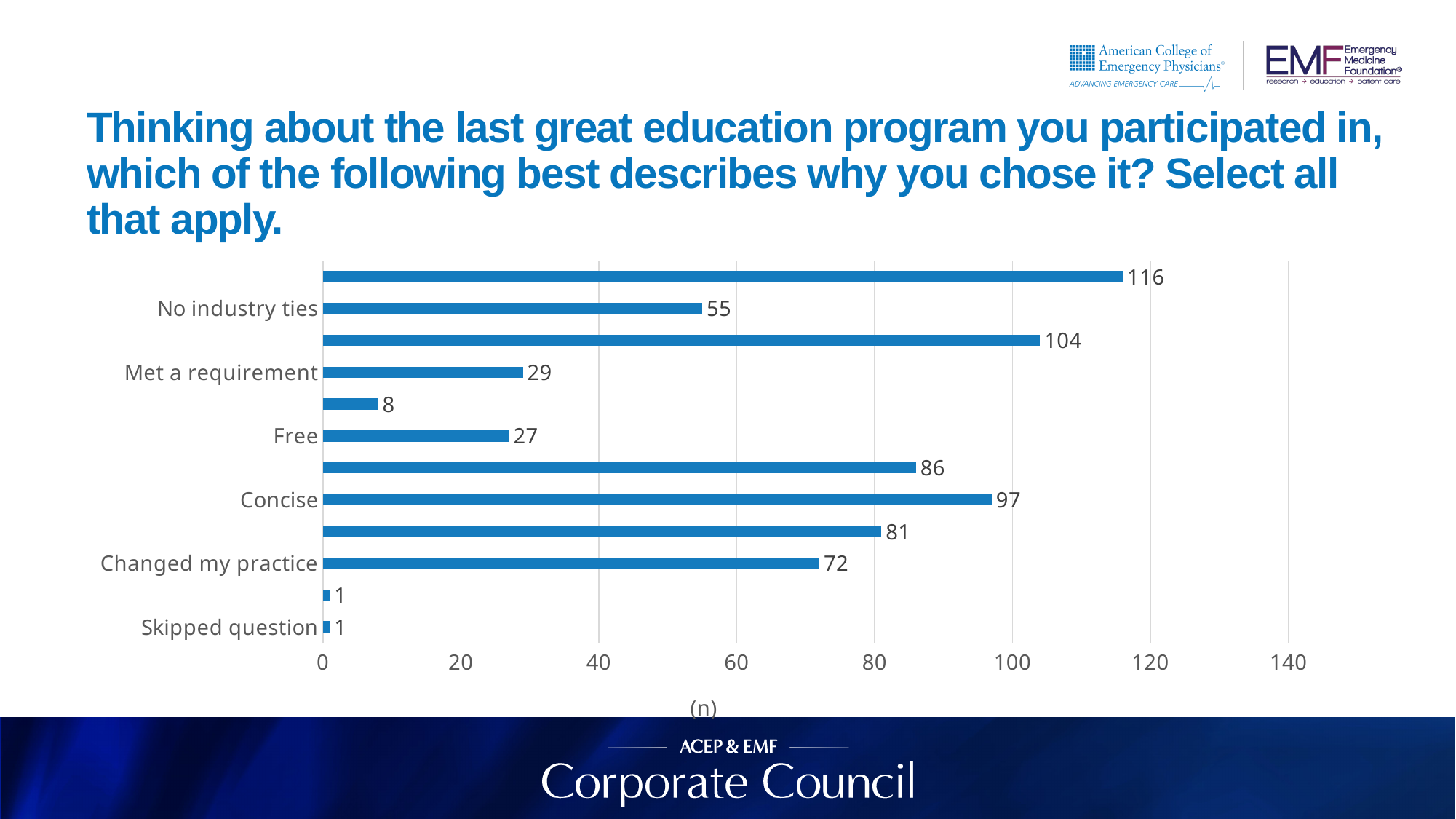
Is the value for "Concise" greater or less than 80? greater What is the value for "Free"? 27 What is the value for "Concise"? 97 Which has a larger value, "No industry ties" or "Met a requirement"? No industry ties How many bars are plotted in the chart? 12 What kind of chart is shown on the slide? Bar chart What is the difference between the values for "Concise" and "Changed my practice"? 25 What is the value for "Skipped question"? 1 What is the largest value labelled on any bar in the chart? 116 What is the value for "Met a requirement"? 29 What is the value for "Changed my practice"? 72 What is the value for "No industry ties"? 55